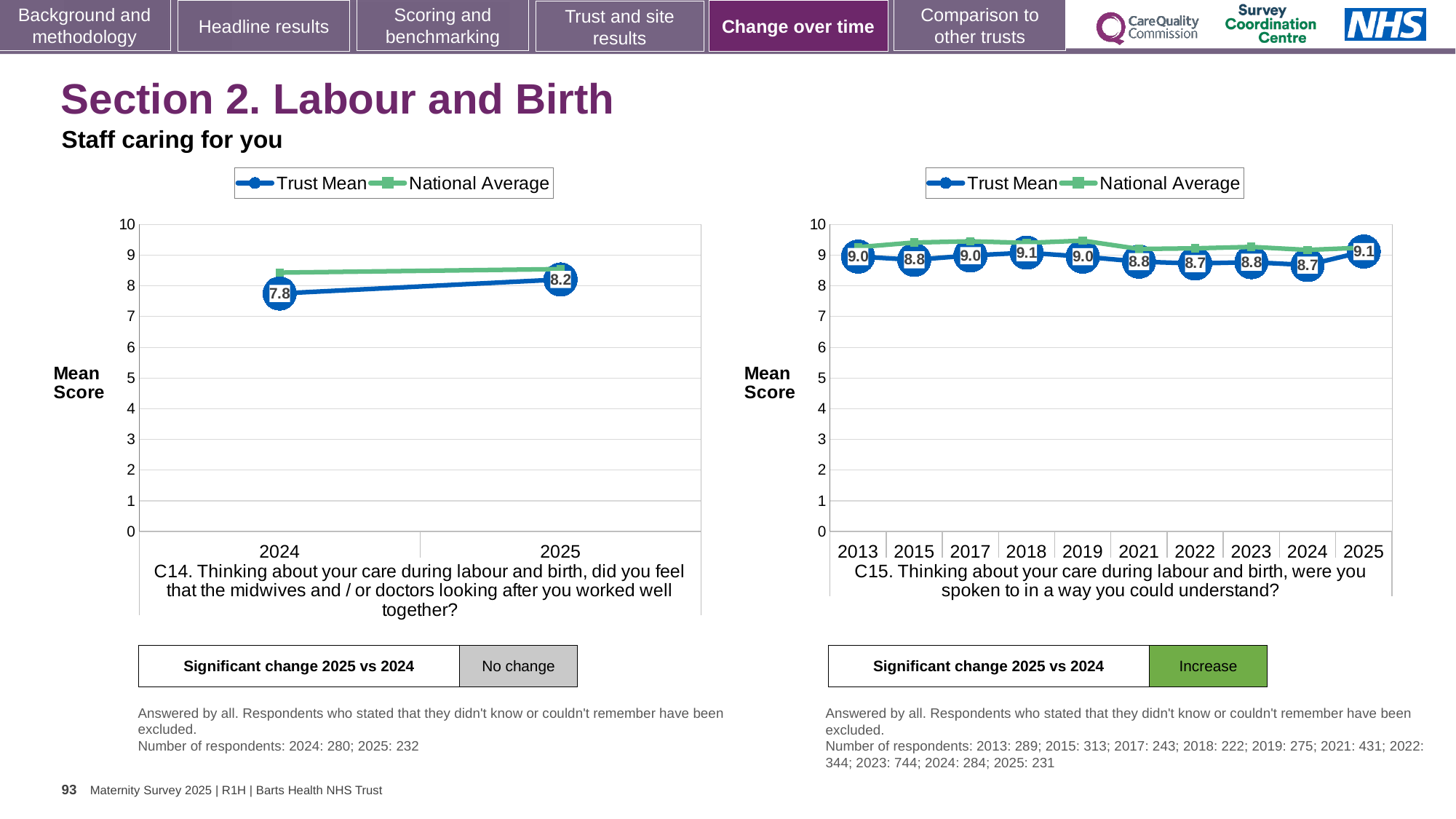
In the left chart (C14), is the National Average for 2024 greater or less than 8? greater In the left chart (C14), what is the Trust Mean for 2025? 8.2 What type of chart is the left chart (C14)? Line chart In the right chart (C15), is the Trust Mean higher in 2024 or 2025? 2025 In the right chart (C15), what is the Trust Mean for 2022? 8.7 In the right chart (C15), what is the Trust Mean for 2025? 9.1 In the left chart (C14), is the Trust Mean higher in 2024 or 2025? 2025 In the right chart (C15), what is the Trust Mean for 2018? 9.1 In the left chart (C14), what is the Trust Mean for 2024? 7.8 In the left chart (C14), by how much did the Trust Mean change from 2024 to 2025? 0.4 In the right chart (C15), how many years are plotted on the x axis? 10 How many series does the legend of the right chart (C15) list? 2